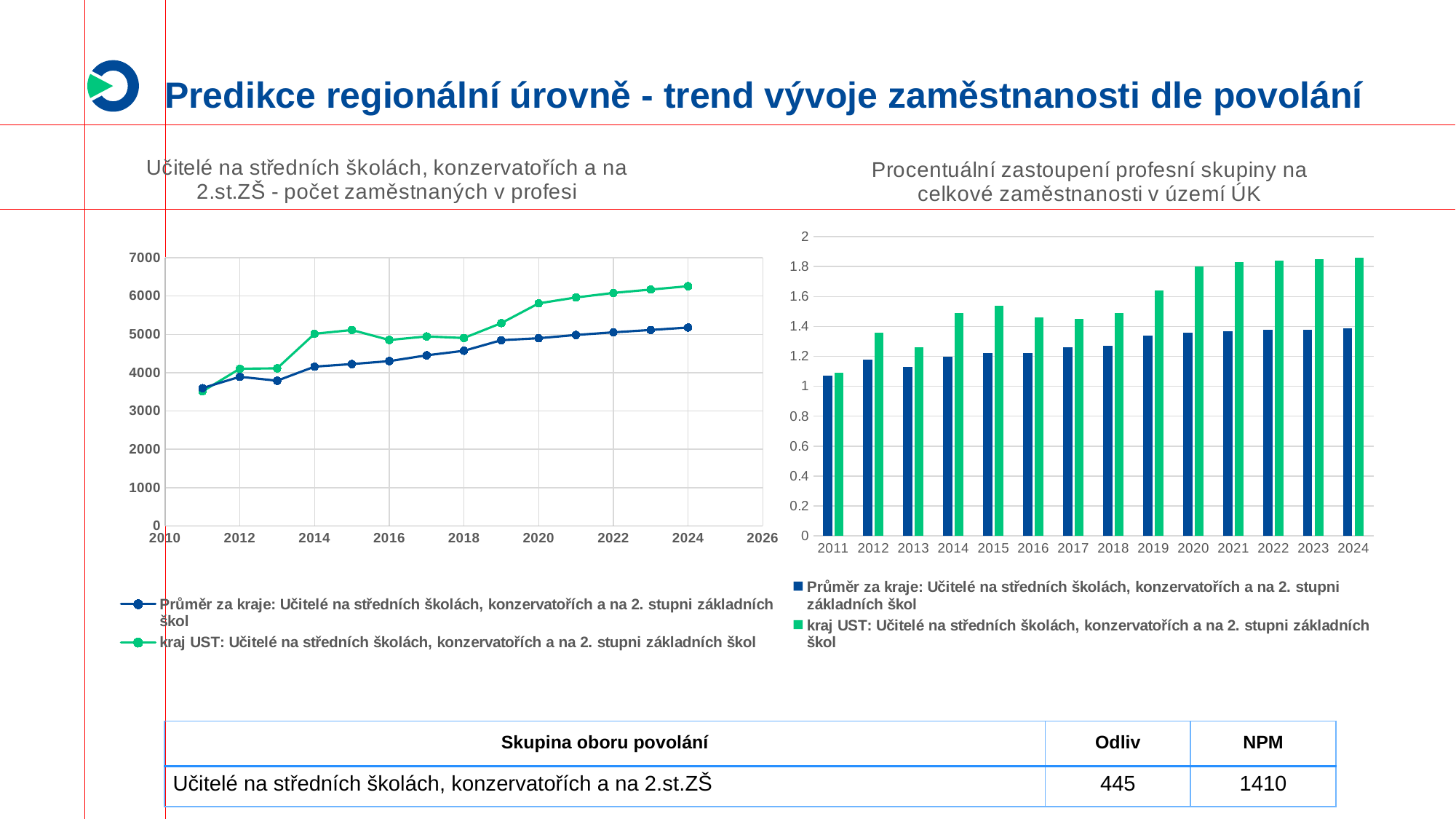
In the left chart, which series has the higher value in 2024, 'Průměr za kraje' or 'kraj UST'? kraj UST In the left chart, does the 'kraj UST' series generally rise or fall from 2011 to 2024? rise In the right chart, which series has the larger value in 2019, 'Průměr za kraje' or 'kraj UST'? kraj UST What kind of chart is the left chart titled 'Učitelé na středních školách, konzervatořích a na 2.st.ZŠ - počet zaměstnaných v profesi'? line chart What kind of chart is the right chart titled 'Procentuální zastoupení profesní skupiny na celkové zaměstnanosti v území ÚK'? bar chart In the left chart, how many series does the legend list? 2 In the right chart, which year has the lowest value for 'kraj UST'? 2011 In the left chart, is the 2024 value for 'kraj UST' greater or less than 6000? greater In the right chart, is the 2024 value for 'kraj UST' greater or less than 1.8? greater In the left chart, is the 2011 value for 'Průměr za kraje' greater or less than 4000? less In the right chart, how many years are shown on the x axis? 14 In the right chart, what colour are the bars for the 'kraj UST' series? green